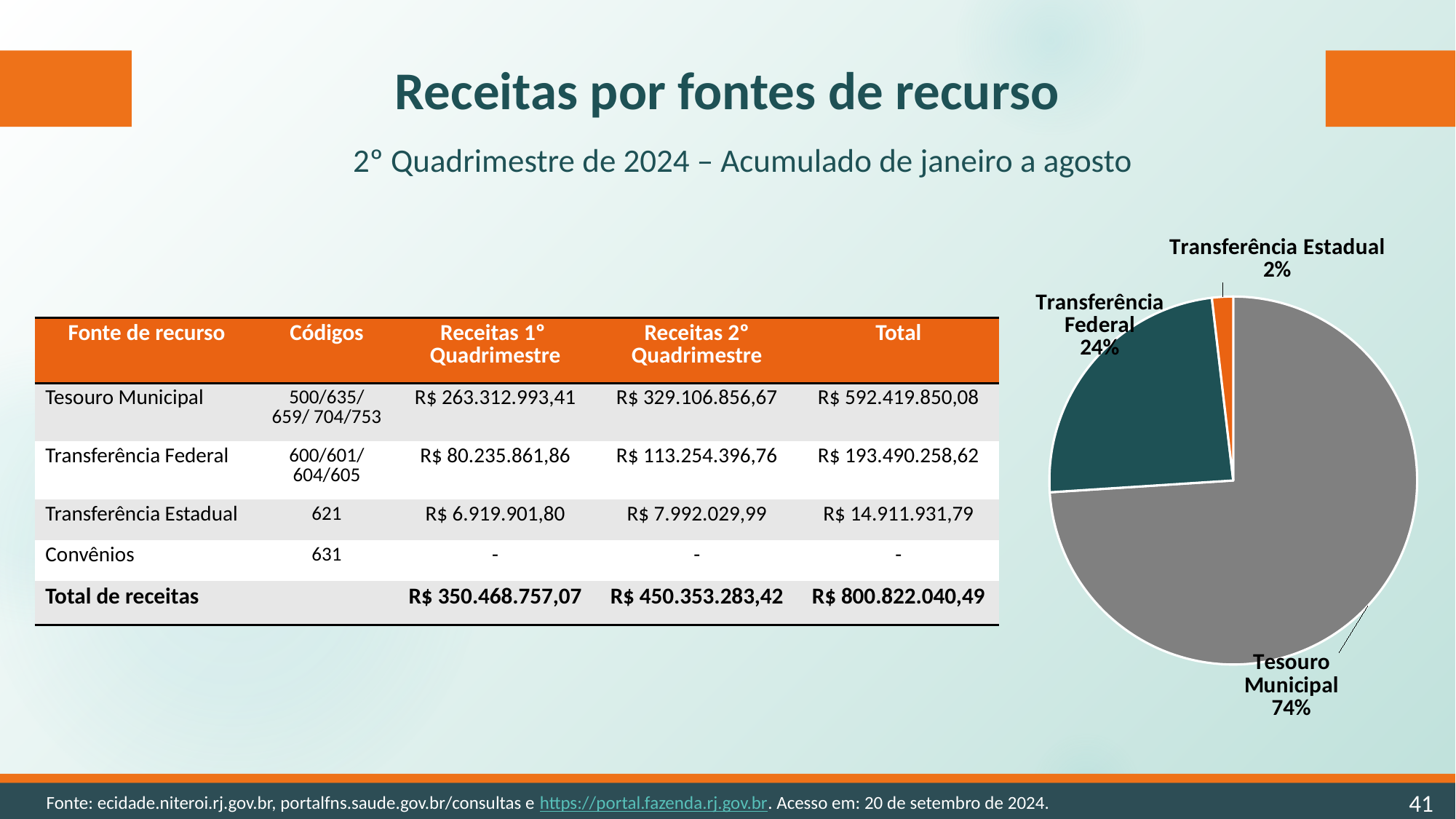
What share of the pie chart does Transferência Estadual represent? 2% What colour is the Transferência Estadual slice in the pie chart? Orange What share of the pie chart does Tesouro Municipal represent? 74% What kind of chart is shown on the slide? Pie chart Which slice of the pie chart is the smallest? Transferência Estadual Which is larger in the pie chart, Transferência Federal or Transferência Estadual? Transferência Federal Is the share for Transferência Federal in the pie chart greater or less than 50%? less How many percentage points larger is the Tesouro Municipal slice than the Transferência Federal slice? 50 Which slice of the pie chart is the largest? Tesouro Municipal How many slices does the pie chart have? 3 What colour is the Tesouro Municipal slice in the pie chart? Grey What share of the pie chart does Transferência Federal represent? 24%